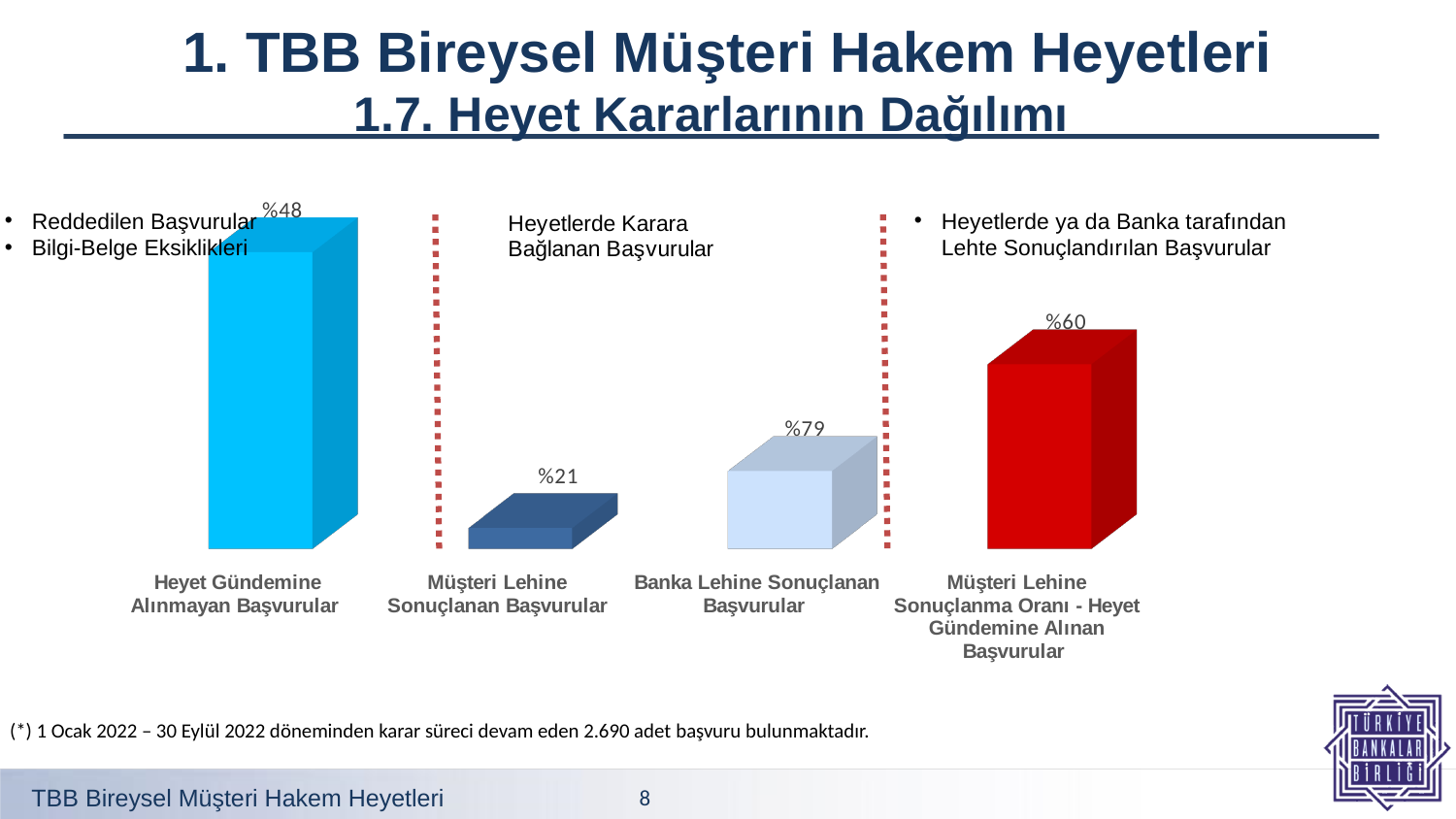
What colour is the bar for Müşteri Lehine Sonuçlanma Oranı - Heyet Gündemine Alınan Başvurular? Red What is the value shown for Banka Lehine Sonuçlanan Başvurular? %79 How many categories are shown in the chart? 4 What is the value shown for Müşteri Lehine Sonuçlanma Oranı - Heyet Gündemine Alınan Başvurular? %60 What is the value shown for Müşteri Lehine Sonuçlanan Başvurular? %21 What is the value shown for Heyet Gündemine Alınmayan Başvurular? %48 What is the difference between the values for Müşteri Lehine Sonuçlanma Oranı - Heyet Gündemine Alınan Başvurular and Heyet Gündemine Alınmayan Başvurular? %12 According to the data labels, which category has the lowest value? Müşteri Lehine Sonuçlanan Başvurular What kind of chart is shown on the slide? Bar chart Which has the larger labelled value: Heyet Gündemine Alınmayan Başvurular or Müşteri Lehine Sonuçlanan Başvurular? Heyet Gündemine Alınmayan Başvurular According to the data labels, which category has the highest value? Banka Lehine Sonuçlanan Başvurular What is the difference between the values for Banka Lehine Sonuçlanan Başvurular and Müşteri Lehine Sonuçlanan Başvurular? %58